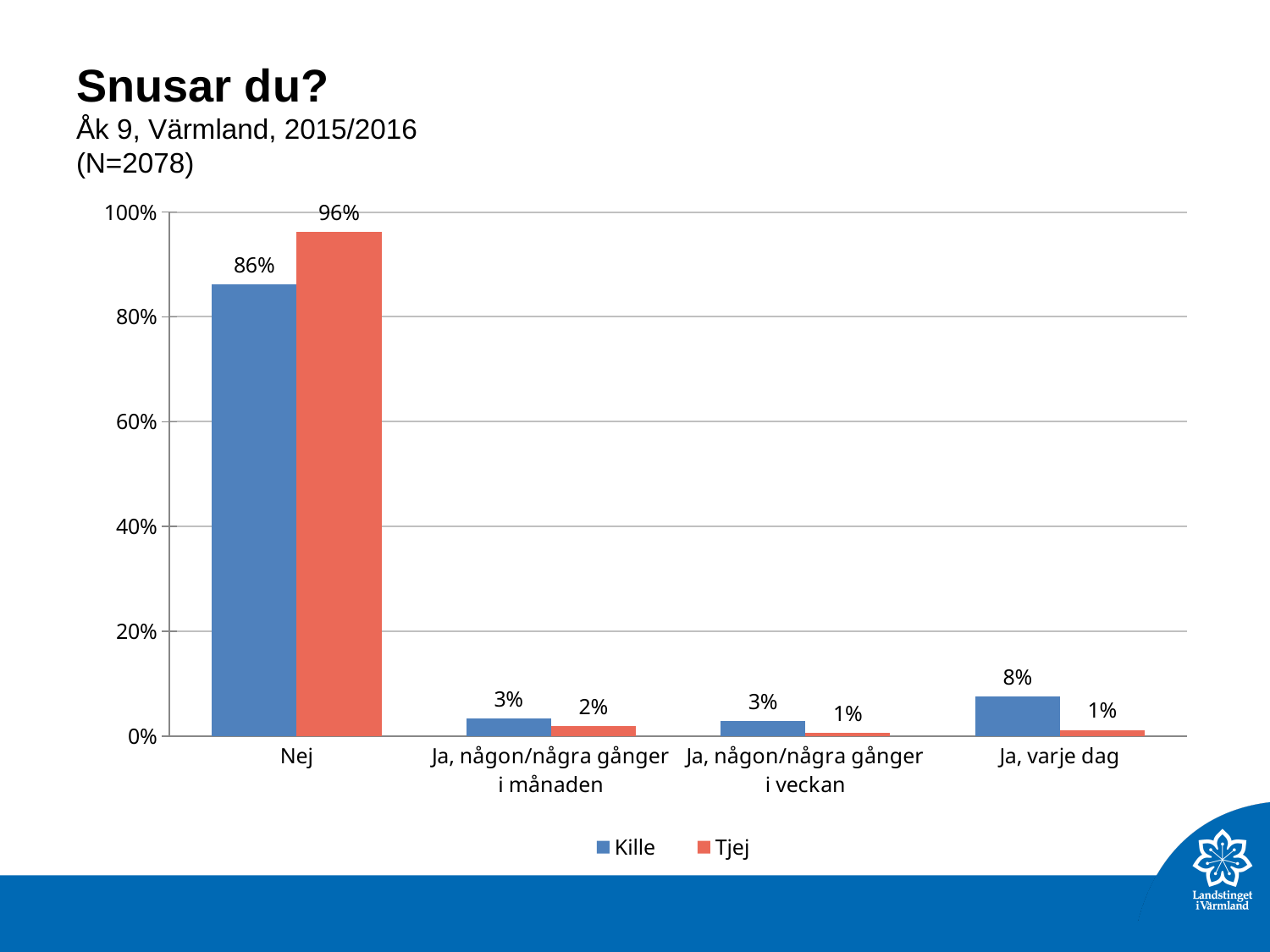
Which category has the highest value for Kille? Nej What is the value for Kille in the 'Ja, varje dag' category? 8% Is the value for Kille in the Nej category greater or less than 80%? greater What is the value for Tjej in the Nej category? 96% What kind of chart is shown on the slide? Bar chart In the 'Ja, varje dag' category, which series has the larger value, Kille or Tjej? Kille What is the difference between the Kille and Tjej values in the 'Ja, varje dag' category? 7% What is the value for Kille in the Nej category? 86% How many categories are shown on the x axis? 4 How many series does the legend list? 2 What is the difference between the Tjej and Kille values in the Nej category? 10% What is the value for Tjej in the 'Ja, någon/några gånger i veckan' category? 1%